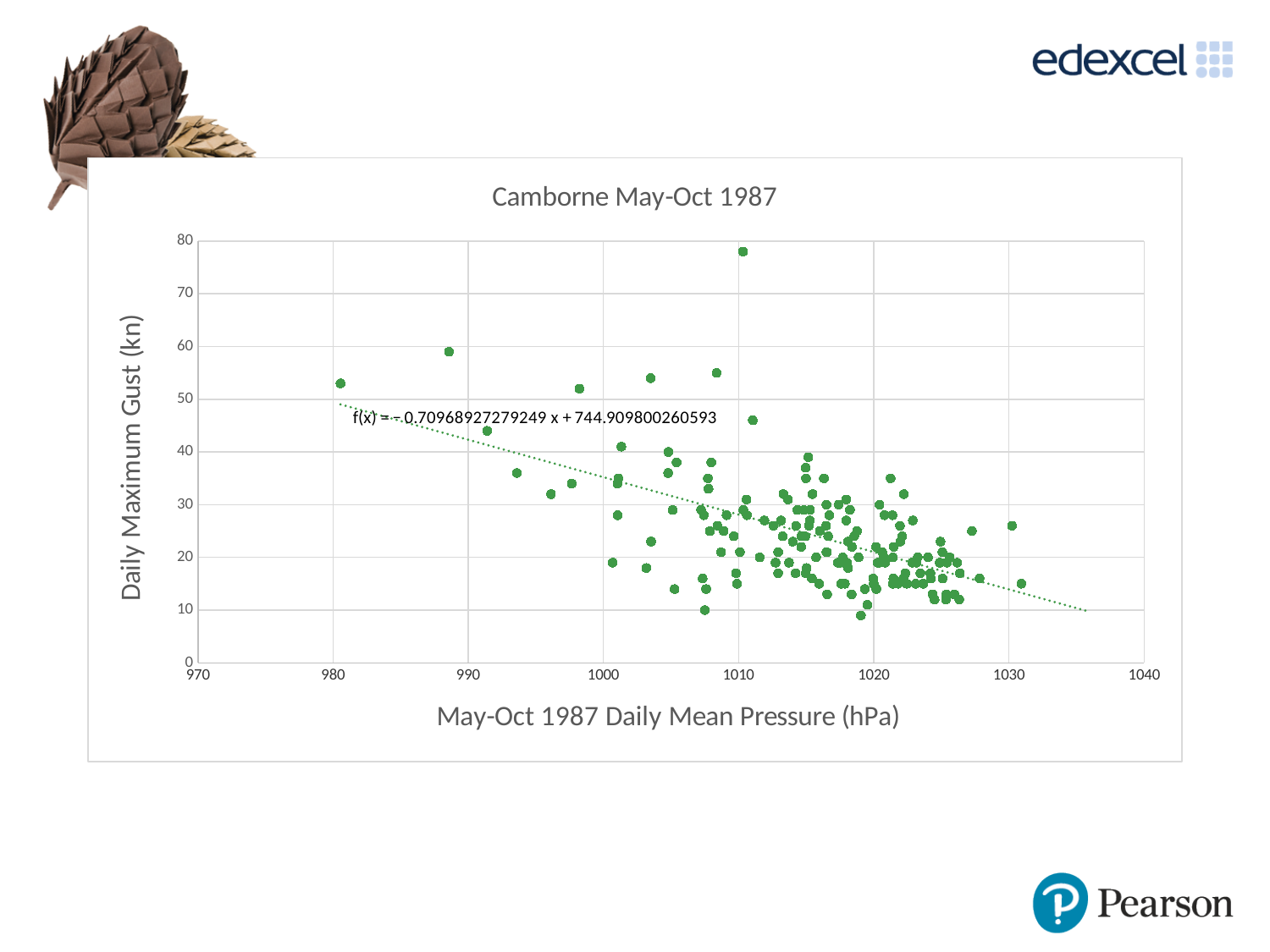
Does the dotted trendline slope upward or downward from left to right? downward Is the highest plotted daily maximum gust value greater or less than 70 kn? greater Is the lowest plotted daily maximum gust value greater or less than 10 kn? less What is the slope of the trendline equation shown on the chart? -0.70968927279249 What kind of chart is shown on the slide? scatter chart What is the title of the chart? Camborne May-Oct 1987 What is the label of the x axis? May-Oct 1987 Daily Mean Pressure (hPa) What is the intercept in the trendline equation shown on the chart? 744.909800260593 As daily mean pressure increases along the x axis, do the daily maximum gust values generally rise or fall? fall Is the daily mean pressure of the highest gust point greater or less than 1000 hPa? greater What is the maximum value shown on the x axis? 1040